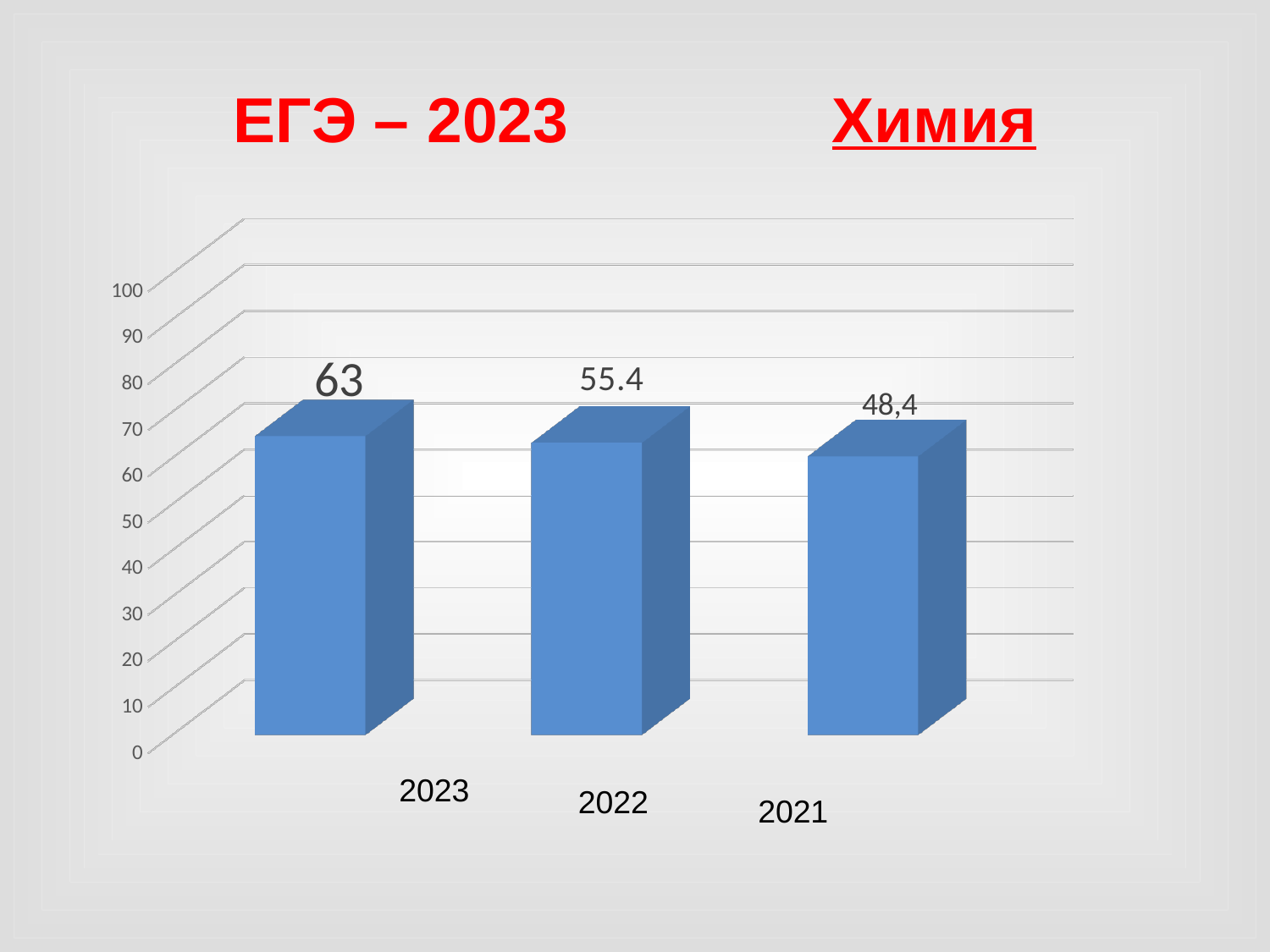
How many bars are shown in the chart? 3 Which is larger, the value for 2022 or the value for 2021? 2022 Do the values rise or fall from left to right along the x axis? fall What is the value shown for 2022? 55.4 What is the difference between the values for 2023 and 2022? 7.6 What is the value shown for 2021? 48,4 What is the value shown for 2023? 63 What subject is named in the slide title? Химия What kind of chart is shown on the slide? bar chart Which year has the lowest value? 2021 Which year has the highest value? 2023